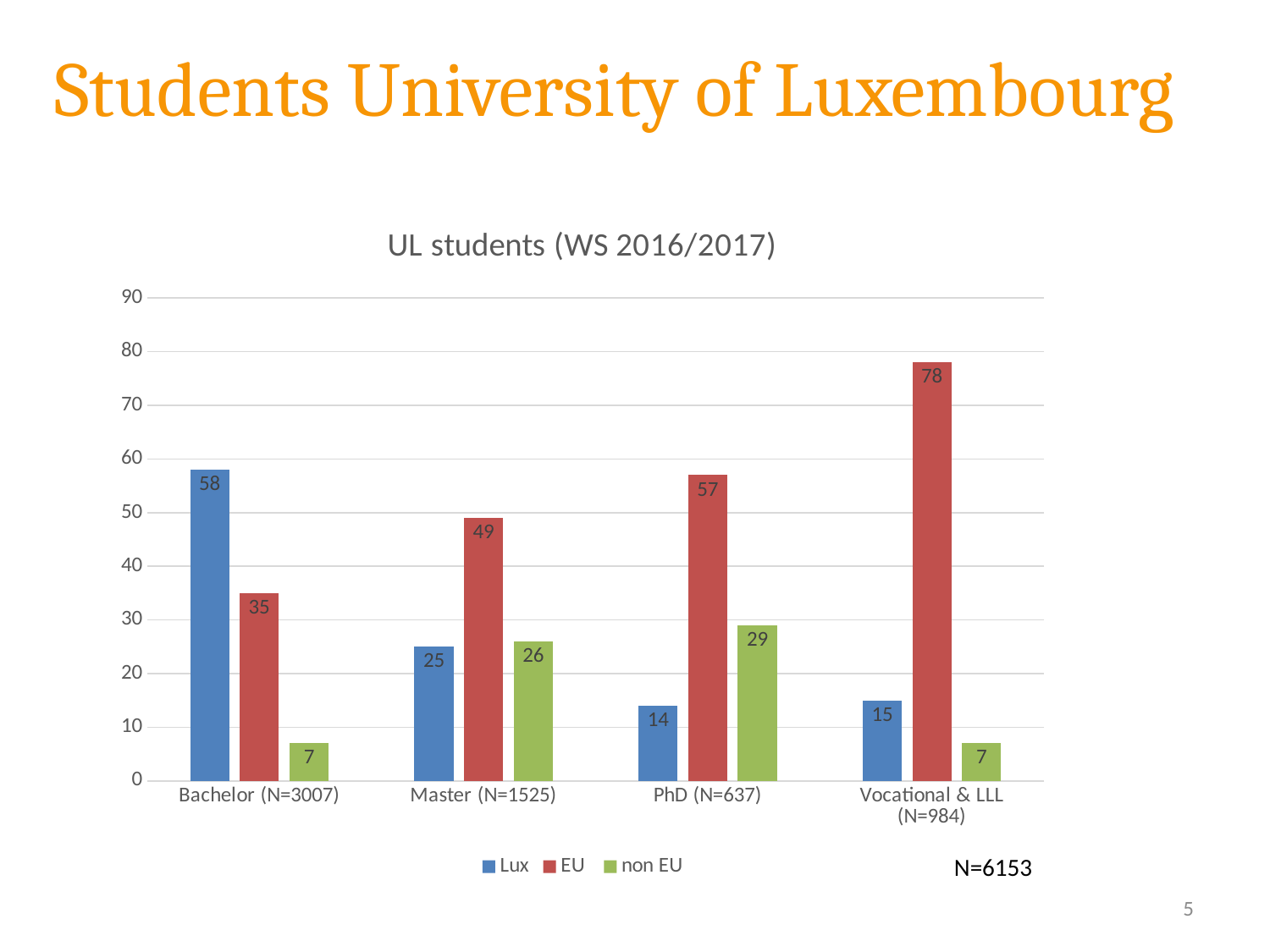
What is the non EU value for PhD (N=637)? 29 How many series does the legend list? 3 What is the title of the chart? UL students (WS 2016/2017) What is the difference between the EU and Lux values for Master (N=1525)? 24 Which category has the lowest Lux value? PhD (N=637) Which is larger for PhD (N=637): the EU value or the non EU value? EU What is the Lux value for Bachelor (N=3007)? 58 How many categories are shown on the x axis? 4 What kind of chart is shown? bar chart Is the Lux value for Bachelor (N=3007) greater or less than 50? greater What is the EU value for Vocational & LLL (N=984)? 78 Which category has the highest EU value? Vocational & LLL (N=984)